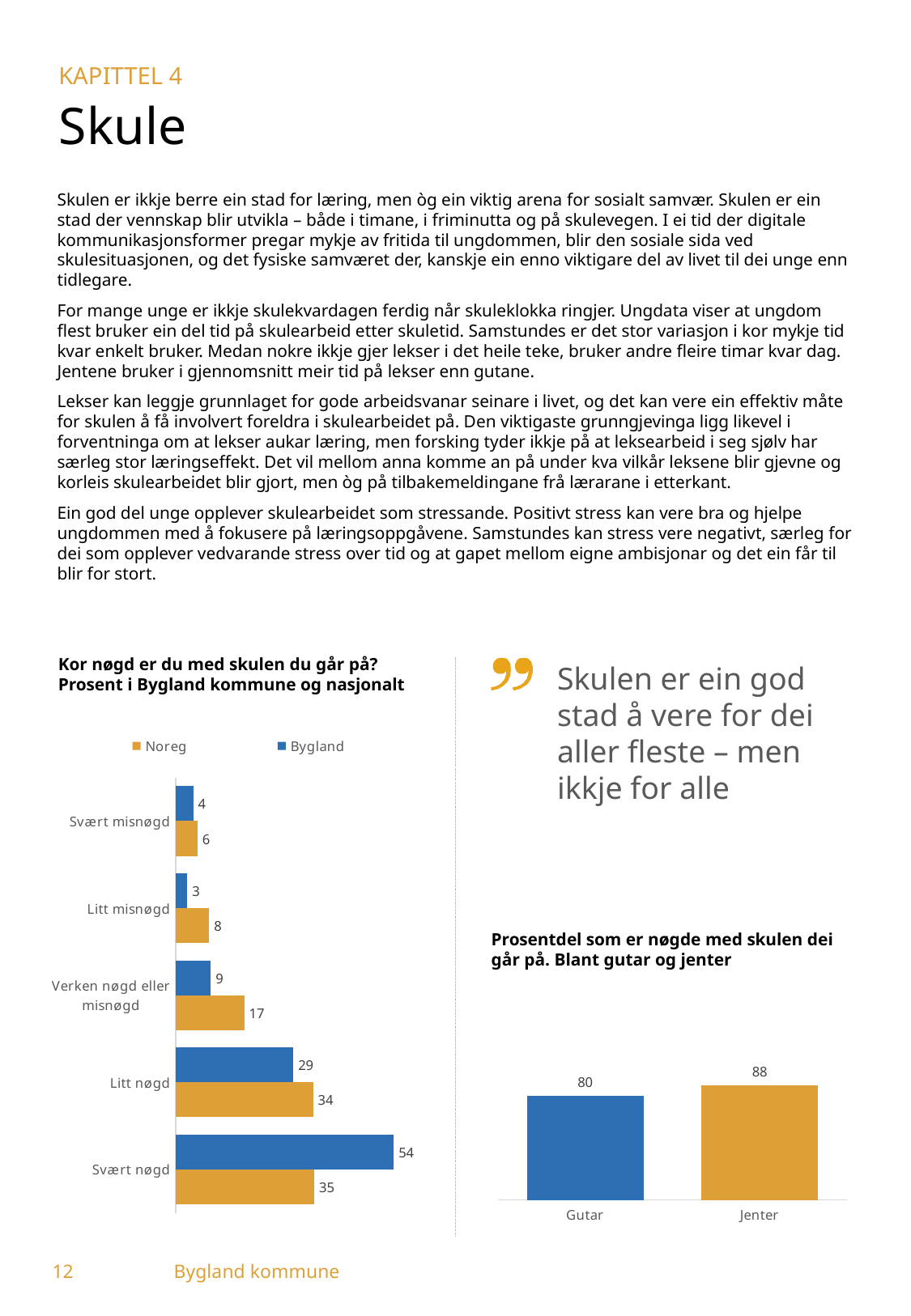
In the chart 'Prosentdel som er nøgde med skulen dei går på', what is the value for Jenter? 88 In the chart 'Kor nøgd er du med skulen du går på?', what is the Noreg value for 'Verken nøgd eller misnøgd'? 17 In the chart 'Kor nøgd er du med skulen du går på?', what is the Noreg value for 'Litt misnøgd'? 8 In the chart 'Kor nøgd er du med skulen du går på?', how many categories are shown? 5 In the chart 'Kor nøgd er du med skulen du går på?', which category has the lowest Bygland value? Litt misnøgd What kind of chart is 'Prosentdel som er nøgde med skulen dei går på'? Bar chart In the chart 'Kor nøgd er du med skulen du går på?', which category has the highest Bygland value? Svært nøgd In the chart 'Prosentdel som er nøgde med skulen dei går på', what is the difference between Jenter and Gutar? 8 In the chart 'Kor nøgd er du med skulen du går på?', which is larger for 'Litt nøgd': the Noreg value or the Bygland value? Noreg In the chart 'Kor nøgd er du med skulen du går på?', how many series does the legend list? 2 In the chart 'Kor nøgd er du med skulen du går på?', what is the Bygland value for 'Svært nøgd'? 54 In the chart 'Kor nøgd er du med skulen du går på?', what is the difference between the Bygland and Noreg values for 'Svært nøgd'? 19